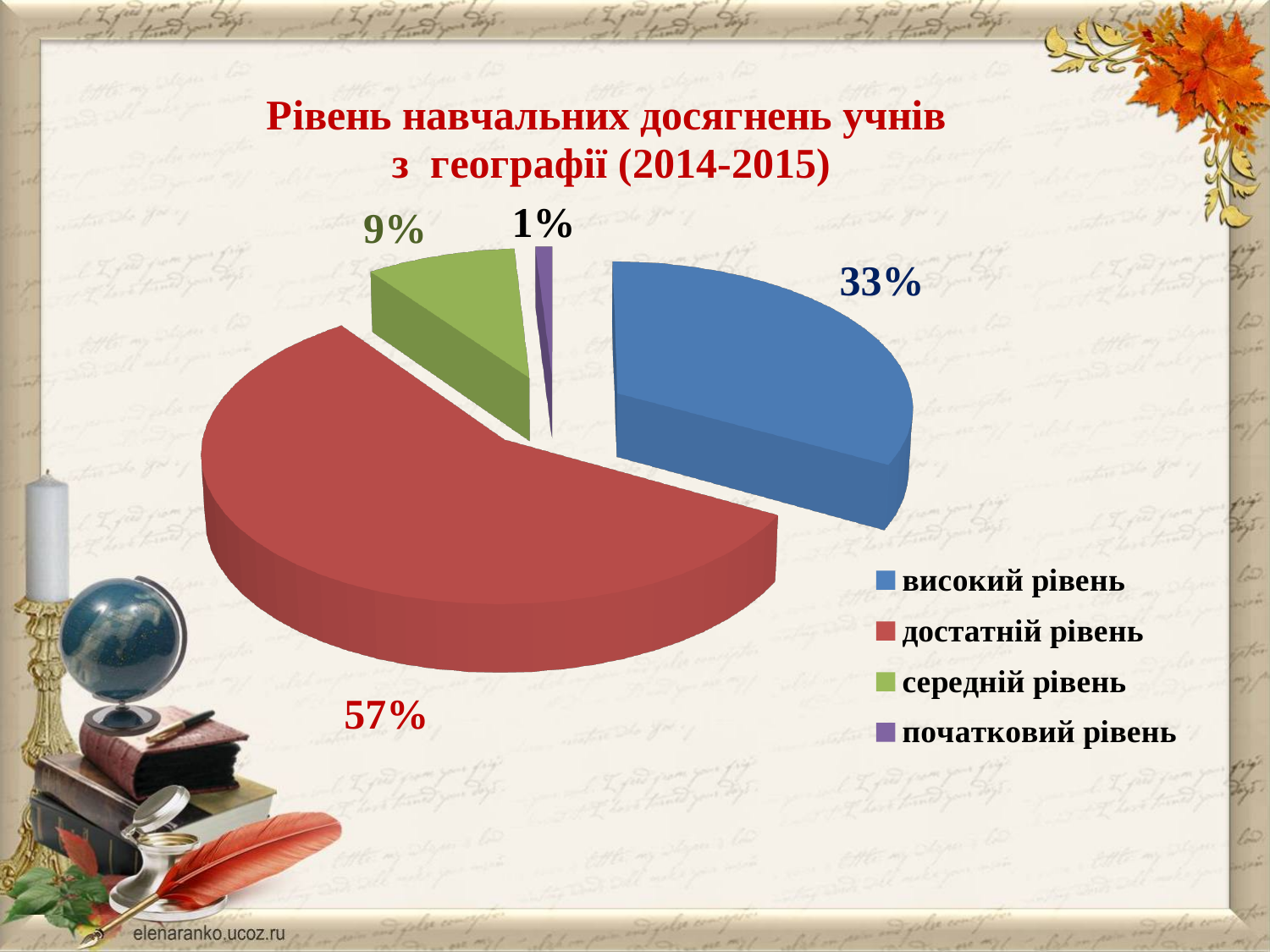
Which category has the largest slice of the pie? достатній рівень What share of the pie is labelled "початковий рівень"? 1% What kind of chart is shown on the slide? pie chart Which category has the smallest slice of the pie? початковий рівень What share of the pie is labelled "середній рівень"? 9% What is the difference in percentage points between "достатній рівень" and "високий рівень"? 24 What share of the pie is labelled "достатній рівень"? 57% How many categories does the legend list? 4 What is the title of the chart? Рівень навчальних досягнень учнів з географії (2014-2015) Which is larger, the share for "середній рівень" or the share for "високий рівень"? високий рівень What colour is the slice for "середній рівень"? green